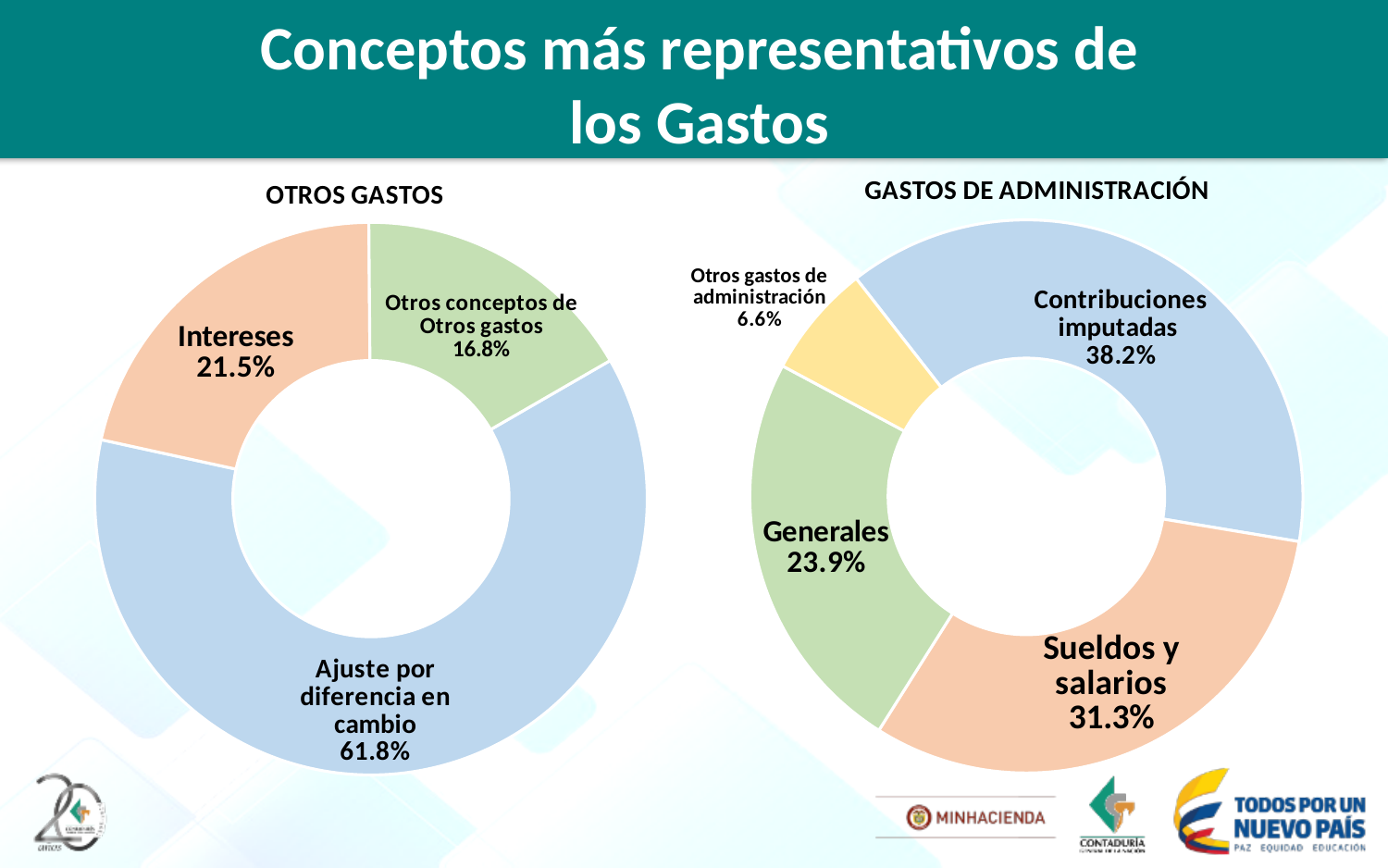
In the GASTOS DE ADMINISTRACIÓN chart, how many categories are shown? 4 In the GASTOS DE ADMINISTRACIÓN chart, which is larger, Generales or Sueldos y salarios? Sueldos y salarios In the OTROS GASTOS chart, what share does Intereses have? 21.5% In the GASTOS DE ADMINISTRACIÓN chart, which category has the largest share? Contribuciones imputadas In the OTROS GASTOS chart, how many categories are shown? 3 In the OTROS GASTOS chart, which category has the largest share? Ajuste por diferencia en cambio In the OTROS GASTOS chart, which category has the smallest share? Otros conceptos de Otros gastos In the OTROS GASTOS chart, what share does Ajuste por diferencia en cambio have? 61.8% In the OTROS GASTOS chart, what is the difference between the shares of Intereses and Otros conceptos de Otros gastos? 4.7% In the GASTOS DE ADMINISTRACIÓN chart, what share does Sueldos y salarios have? 31.3% In the GASTOS DE ADMINISTRACIÓN chart, what share does Otros gastos de administración have? 6.6% What type of chart is the GASTOS DE ADMINISTRACIÓN chart? Doughnut chart